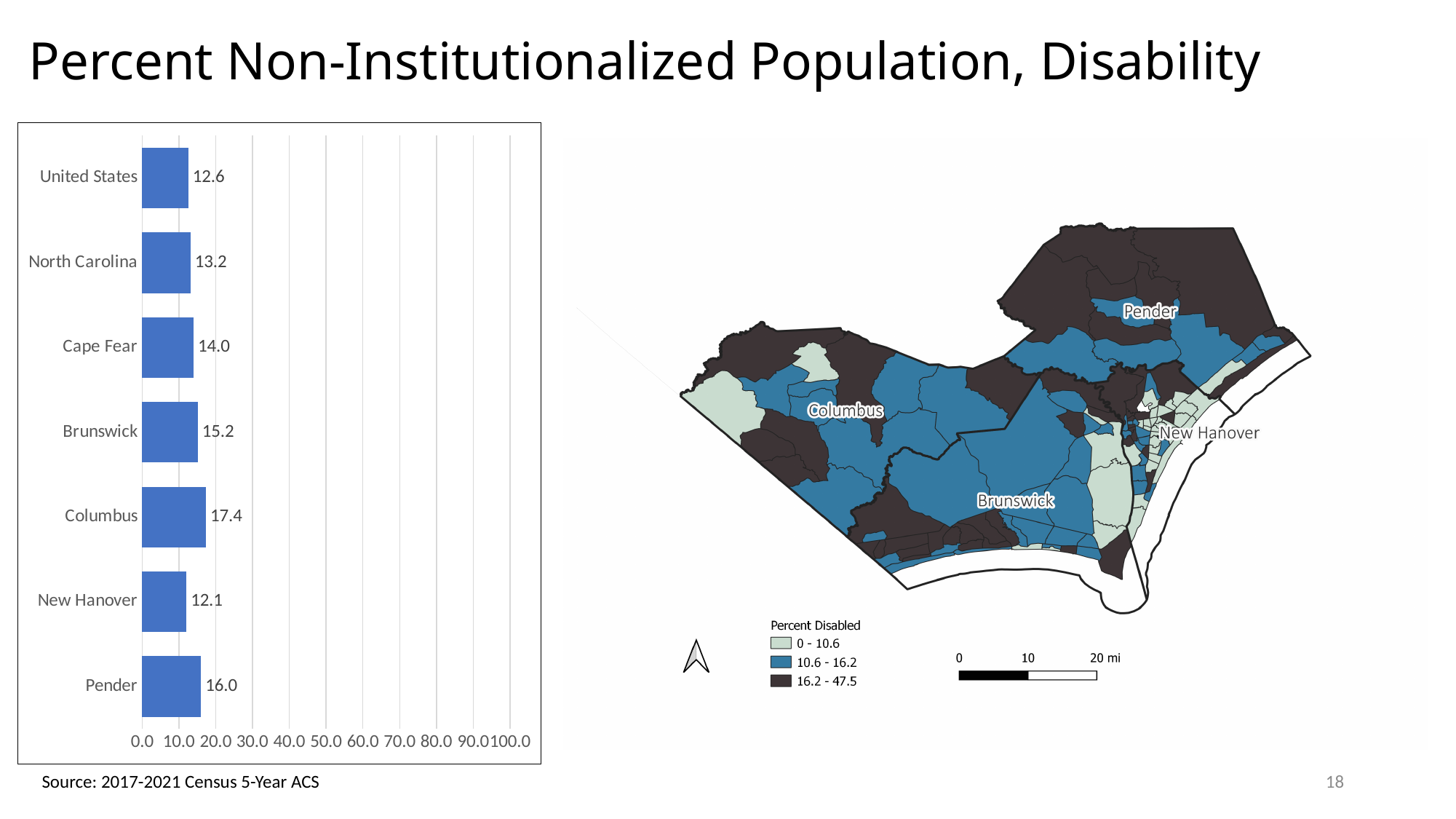
Is the value for Columbus in the bar chart greater or less than 20.0? less What kind of chart is shown on the left of the slide? bar chart What is the value for North Carolina in the bar chart? 13.2 What is the value for Pender in the bar chart? 16.0 What is the difference between the values for Brunswick and Cape Fear in the bar chart? 1.2 What is the highest value on the x axis of the bar chart? 100.0 What is the value for Columbus in the bar chart? 17.4 What is the difference between the values for Columbus and New Hanover in the bar chart? 5.3 How many categories are shown in the bar chart? 7 Which is larger in the bar chart, the value for Pender or the value for Brunswick? Pender Which category has the lowest value in the bar chart? New Hanover Which category has the highest value in the bar chart? Columbus